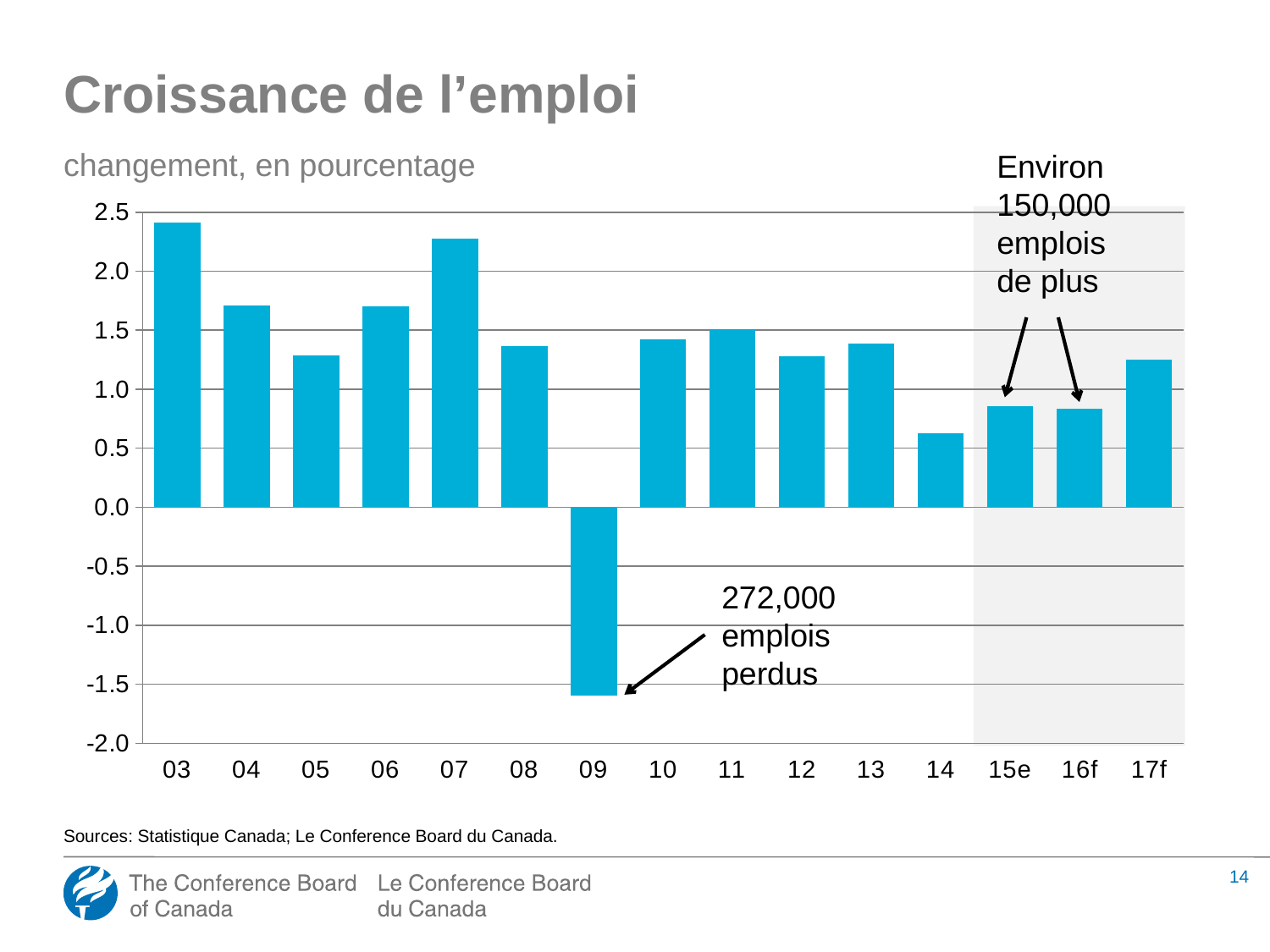
Is the value for 15e greater or less than 1.0? less Which year has the lowest employment growth? 09 What kind of chart is shown on the slide? bar chart What is the title of the chart? Croissance de l'emploi According to the annotation, how many jobs were lost in 09? 272,000 Which year has the highest employment growth? 03 Which is larger, the value for 14 or the value for 17f? 17f Is the value for 03 greater or less than 2.0? greater Which is larger, the value for 07 or the value for 08? 07 How many years (categories) are plotted on the x axis? 15 Is the value for 14 greater or less than 0.5? greater